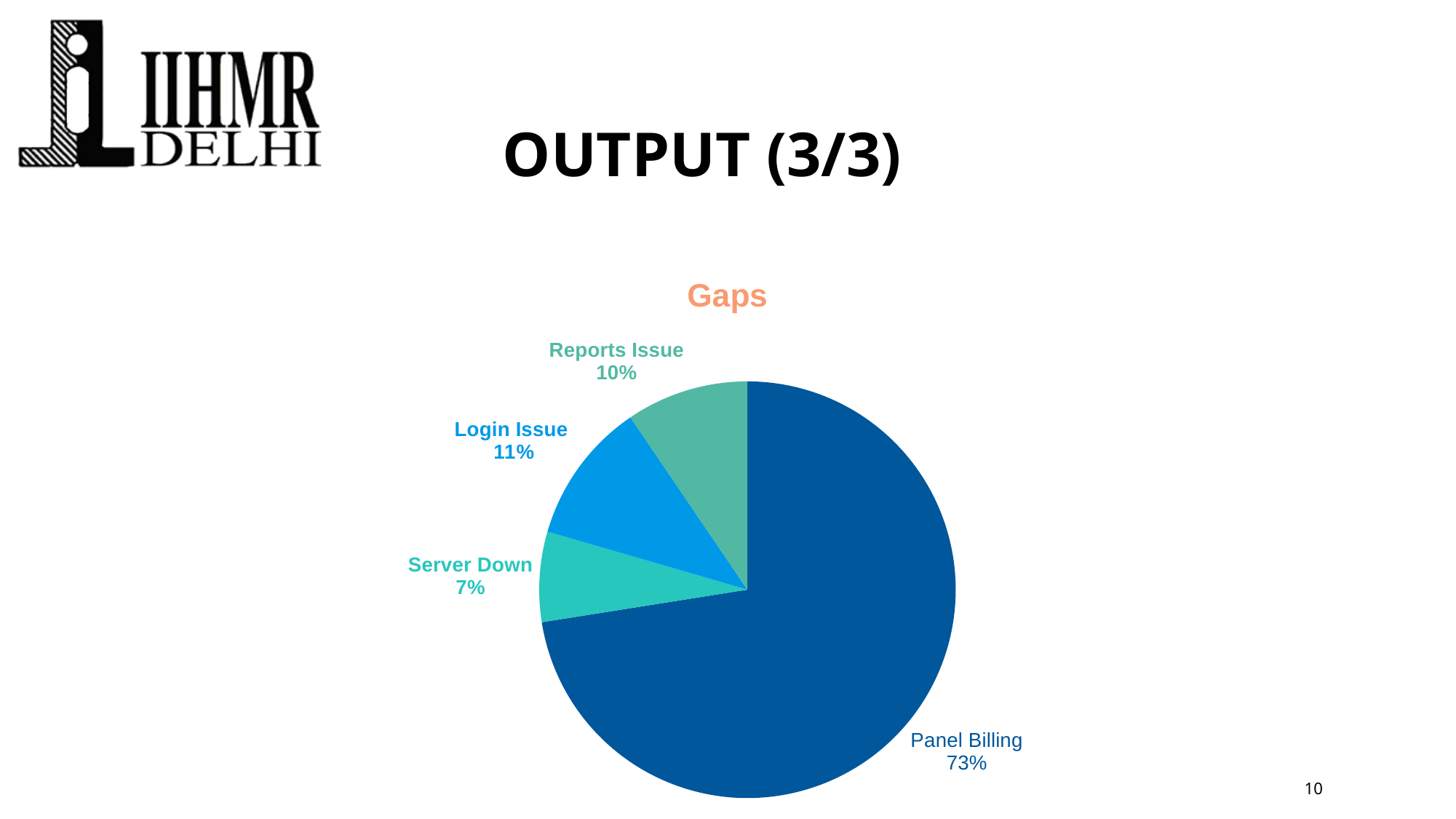
What is the difference in percentage points between Panel Billing and Login Issue? 62 What share of the pie does Server Down represent? 7% Which category has the smallest slice of the pie? Server Down What is the difference in percentage points between Reports Issue and Server Down? 3 What share of the pie does Login Issue represent? 11% What is the title of the chart? Gaps What type of chart is shown on the slide? pie chart What share of the pie does Panel Billing represent? 73% How many categories are shown in the pie chart? 4 Which category has the largest slice of the pie? Panel Billing Which is larger, the share for Login Issue or the share for Server Down? Login Issue